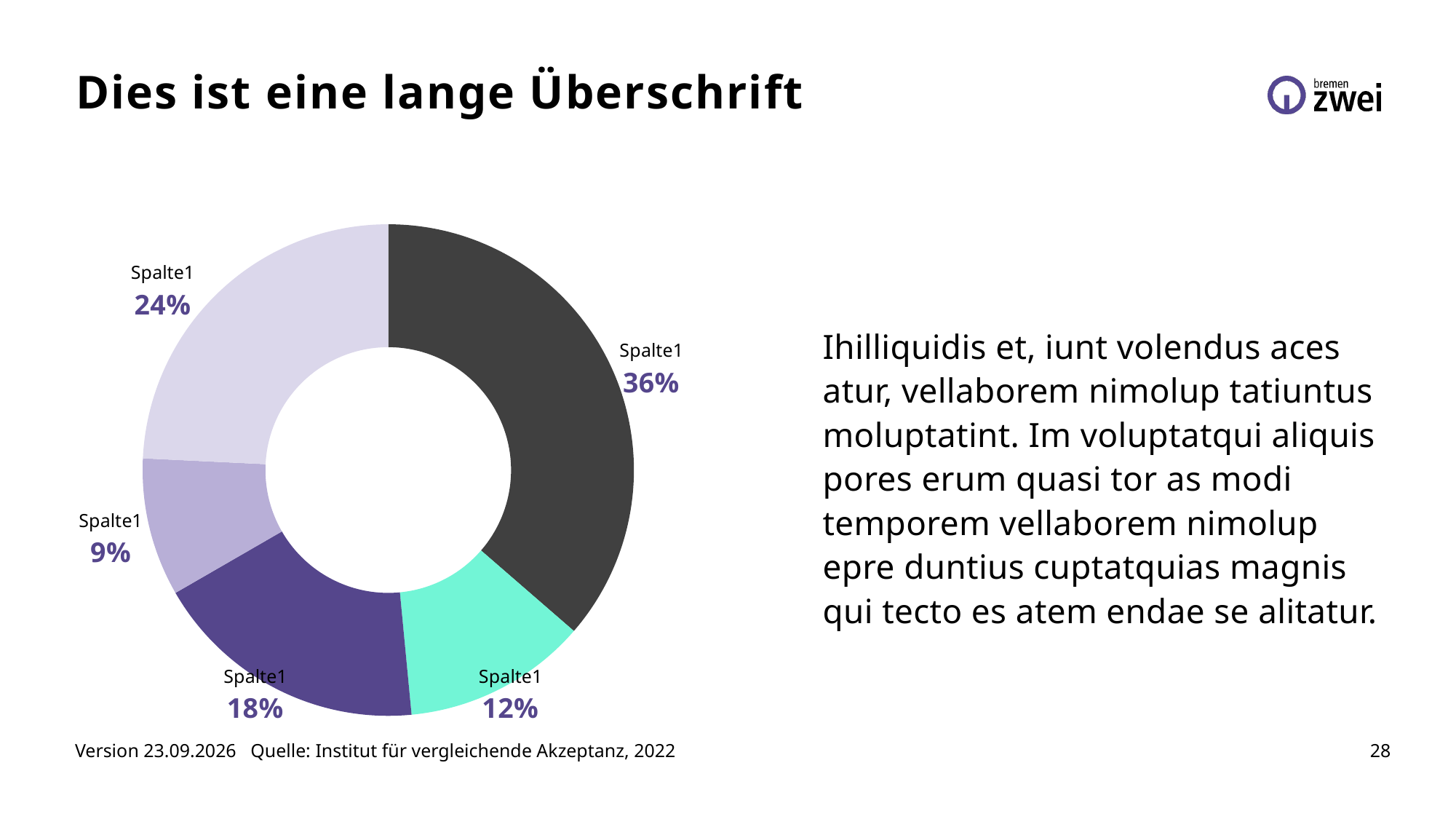
What is the value of the smallest slice in the pie chart? 9% Which slice is larger: the dark purple slice or the pale lavender slice at the top left? the pale lavender slice (24%) What is the value of the largest slice in the pie chart? 36% What is the difference in percentage points between the dark grey slice and the mint green slice? 24 percentage points What percentage is shown for the dark grey slice of the pie chart? 36% How many slices does the pie chart have? 5 What percentage is shown for the dark purple slice of the pie chart? 18% What share of the pie does the pale lavender slice at the top left represent? 24% What label is shown for every slice of the pie chart? Spalte1 What kind of chart is shown on the slide? pie chart (donut) What percentage is shown for the mint green slice of the pie chart? 12% What colour is the largest slice of the pie chart? dark grey